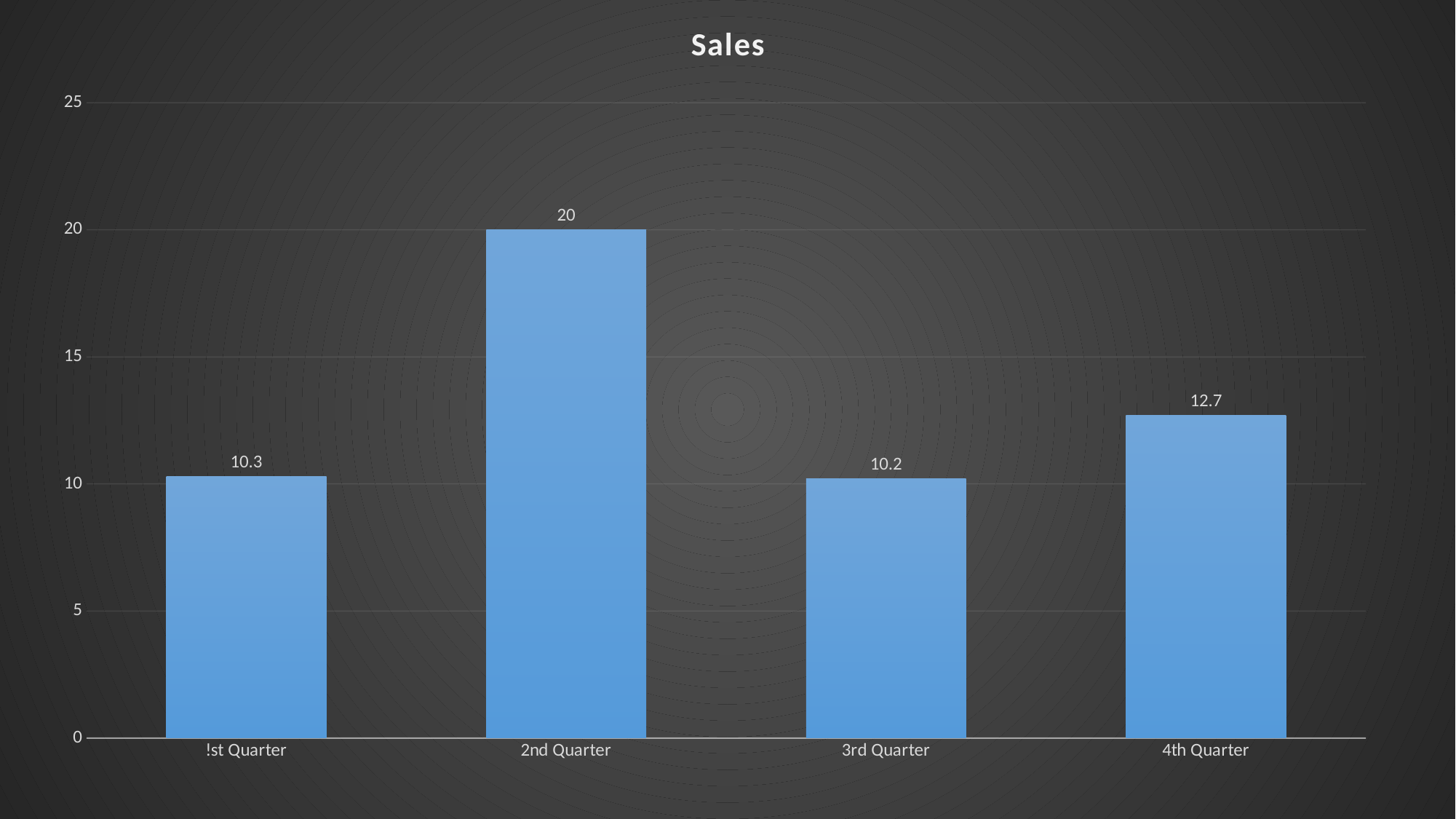
What is the difference between the values for 2nd Quarter and 4th Quarter? 7.3 How many quarters are shown on the chart? 4 What is the title of the chart? Sales What is the difference between the values for 1st Quarter and 3rd Quarter? 0.1 Which is larger, the value for 4th Quarter or the value for 1st Quarter? 4th Quarter What kind of chart is shown on the slide? bar chart Which quarter has the lowest value? 3rd Quarter What is the value for 4th Quarter? 12.7 Is the value for 2nd Quarter greater or less than 15? greater Which quarter has the highest value? 2nd Quarter What is the value for 3rd Quarter? 10.2 What is the value for 2nd Quarter? 20